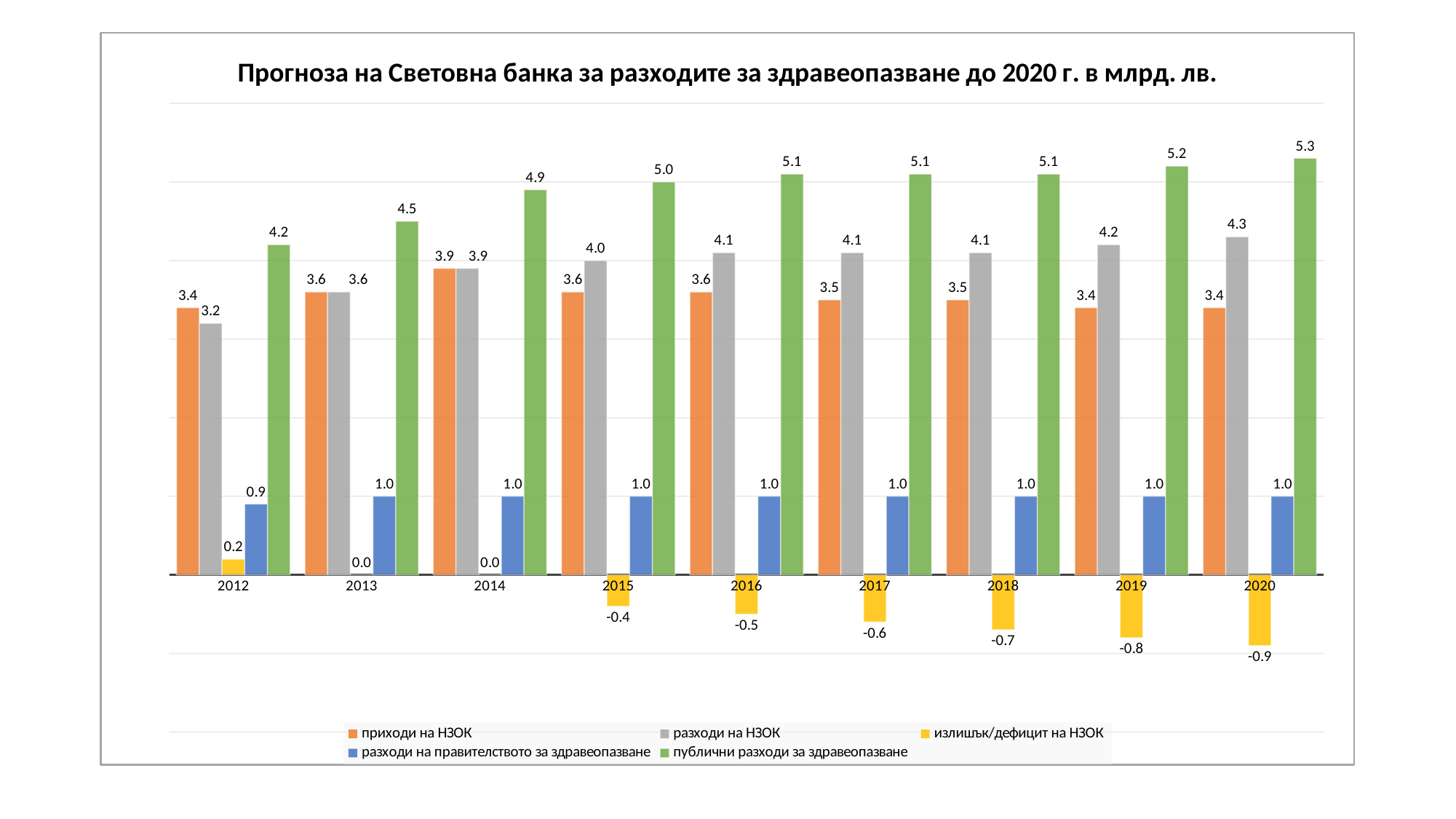
In which year is приходи на НЗОК highest? 2014 How many series does the legend list? 5 What is the value of приходи на НЗОК for 2014? 3.9 Do the values of публични разходи за здравеопазване rise or fall from 2012 to 2020? rise How many years are shown on the x axis? 9 In which year is излишък/дефицит на НЗОК lowest? 2020 What is the difference between разходи на НЗОК and приходи на НЗОК in 2020? 0.9 What is the value of публични разходи за здравеопазване for 2020? 5.3 What is the value of излишък/дефицит на НЗОК for 2019? -0.8 Which is larger in 2012: приходи на НЗОК or разходи на НЗОК? приходи на НЗОК What kind of chart is this? bar chart What is the value of разходи на правителството за здравеопазване for 2012? 0.9